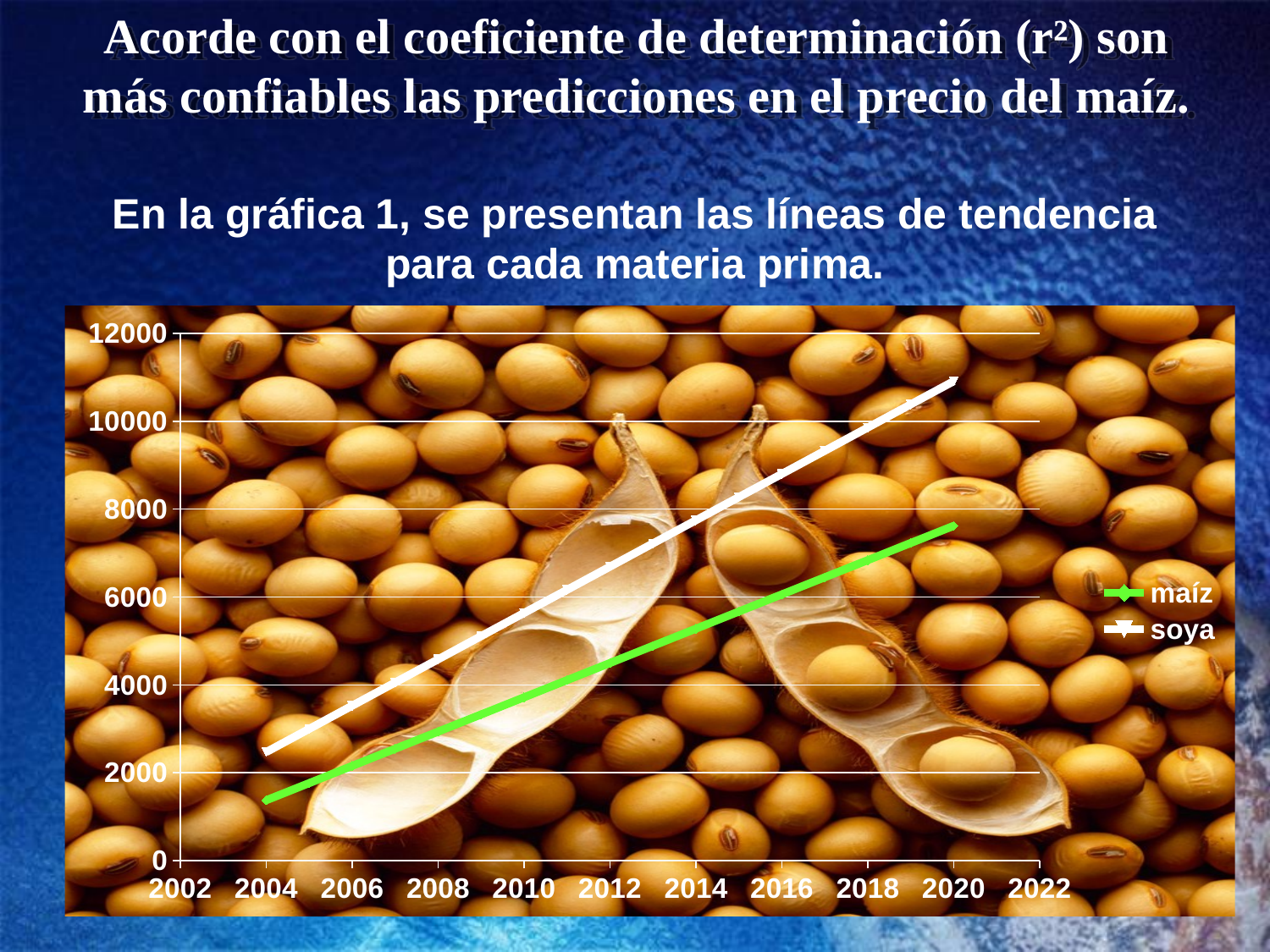
Do the values for soya rise or fall from 2004 to 2020? rise Which two series are listed in the legend? maíz and soya Which series has the higher value in 2020, maíz or soya? soya Is the value for soya in 2020 greater or less than 10000? greater Do the values for maíz rise or fall from 2004 to 2020? rise Is the value for maíz in 2004 greater or less than 2000? less How many series does the legend list? 2 Is the value for maíz in 2020 greater or less than 8000? less Which series has the higher value in 2012, maíz or soya? soya What kind of chart is shown on the slide? line chart What colour is the line for soya? white